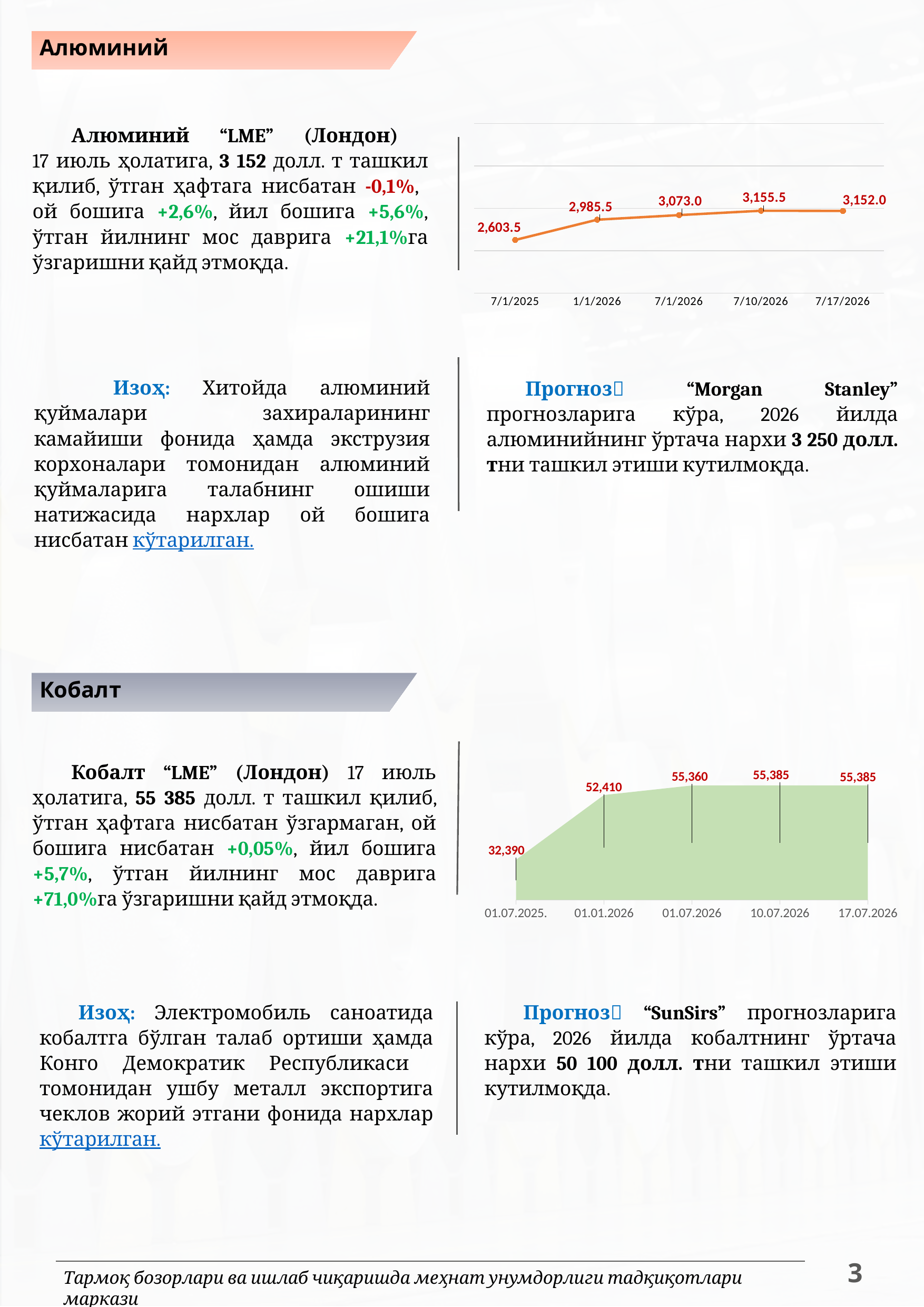
In the cobalt chart (bottom right), do the values generally rise or fall from 01.07.2025. to 17.07.2026? Rise In the cobalt chart (bottom right), is the value for 01.07.2026 larger or smaller than the value for 01.01.2026? Larger In the aluminium chart (top right), which date has the highest value? 7/10/2026 In the aluminium chart (top right), which date has the lowest value? 7/1/2025 In the cobalt chart (bottom right), which date has the lowest value? 01.07.2025. In the aluminium chart (top right), what is the value for 7/17/2026? 3,152.0 In the aluminium chart (top right), how many data points are plotted? 5 In the cobalt chart (bottom right), what is the value for 01.01.2026? 52,410 In the aluminium chart (top right), what is the value for 7/1/2025? 2,603.5 In the cobalt chart (bottom right), what is the difference between the values for 17.07.2026 and 01.07.2025.? 22,995 In the aluminium chart (top right), what is the difference between the values for 1/1/2026 and 7/1/2025? 382.0 What kind of chart is the aluminium chart (top right)? Line chart